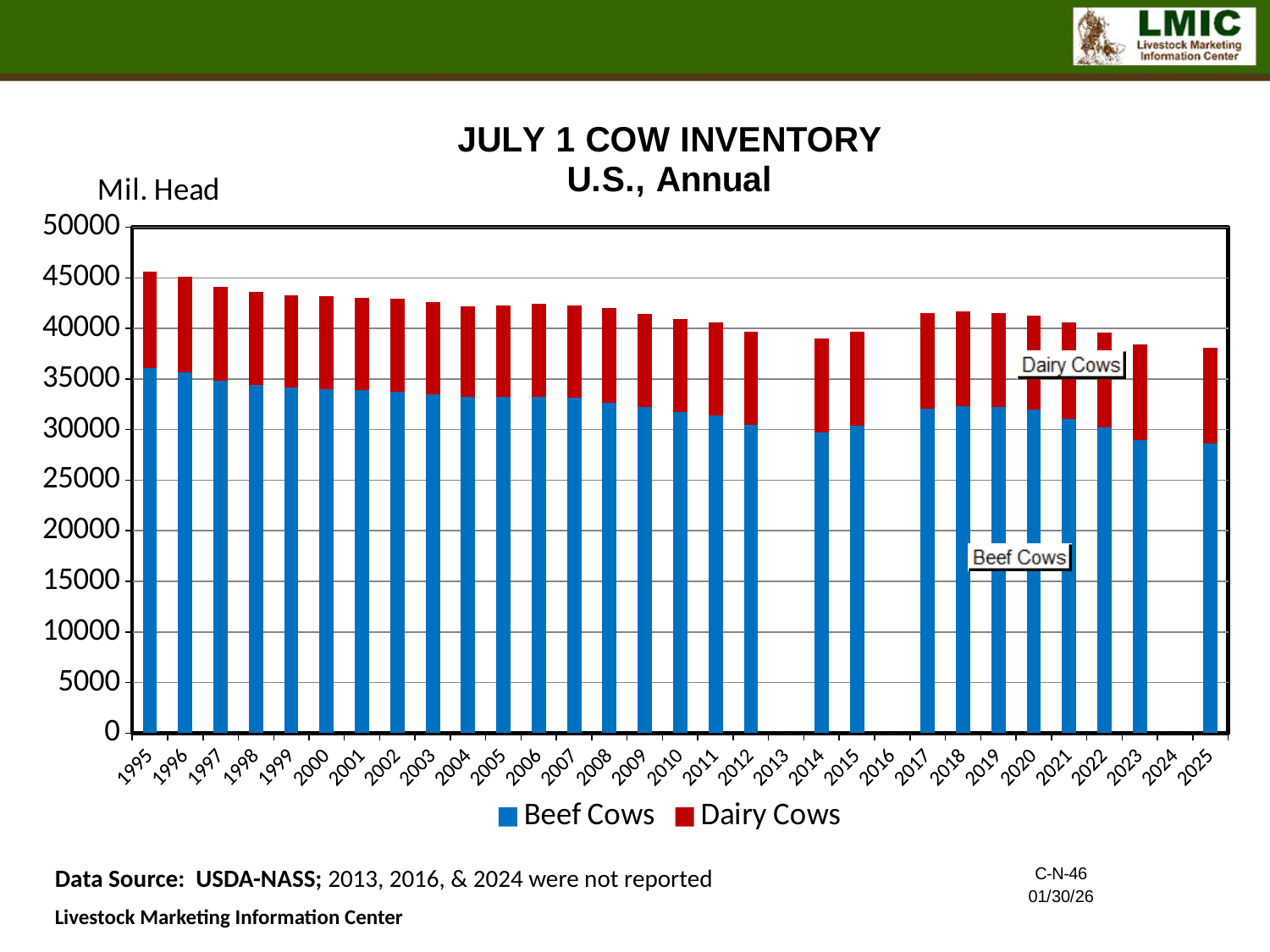
Is the Beef Cows value for 2025 greater or less than 30000? less How many year labels are shown on the x axis? 31 Which is larger, the total cow inventory in 1995 or in 2025? 1995 Which years on the x axis have no bar plotted? 2013, 2016, 2024 How many series does the legend list? 2 Do the Beef Cows values rise or fall from 1995 to 2012? Fall Is the total cow inventory for 2025 greater or less than 40000? less Which year has the highest total cow inventory? 1995 What colour represents Dairy Cows in the chart? Red What kind of chart is shown on the slide? Stacked bar chart Which year has the highest Beef Cows value? 1995 Is the Beef Cows value for 1995 greater or less than 35000? greater